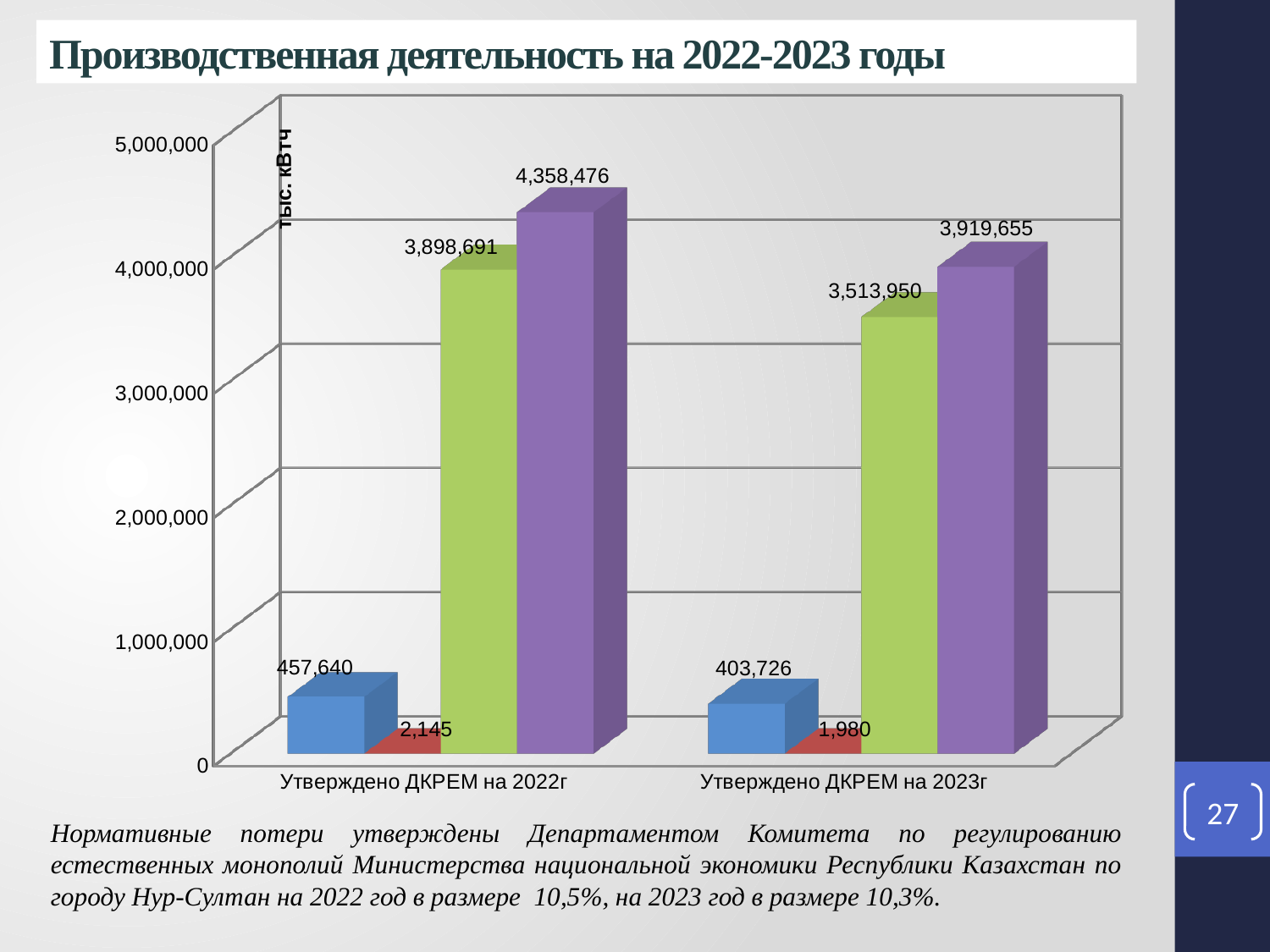
What is the difference between the green bar values for 2022 (3,898,691) and 2023 (3,513,950)? 384,741 What unit label is shown on the vertical axis of the chart? тыс. кВтч What is the value of the blue bar for "Утверждено ДКРЕМ на 2022г"? 457,640 What is the difference between the purple bar values for 2022 (4,358,476) and 2023 (3,919,655)? 438,821 Do the green bar values rise or fall from 2022 to 2023? fall What is the value of the red bar for "Утверждено ДКРЕМ на 2023г"? 1,980 What is the value of the purple bar for "Утверждено ДКРЕМ на 2022г"? 4,358,476 What is the value of the green bar for "Утверждено ДКРЕМ на 2023г"? 3,513,950 Which category has the higher purple bar value? Утверждено ДКРЕМ на 2022г What type of chart is shown on the slide? bar chart Is the blue bar value for "Утверждено ДКРЕМ на 2023г" greater or less than 1,000,000? less How many categories are shown on the x axis of the chart? 2